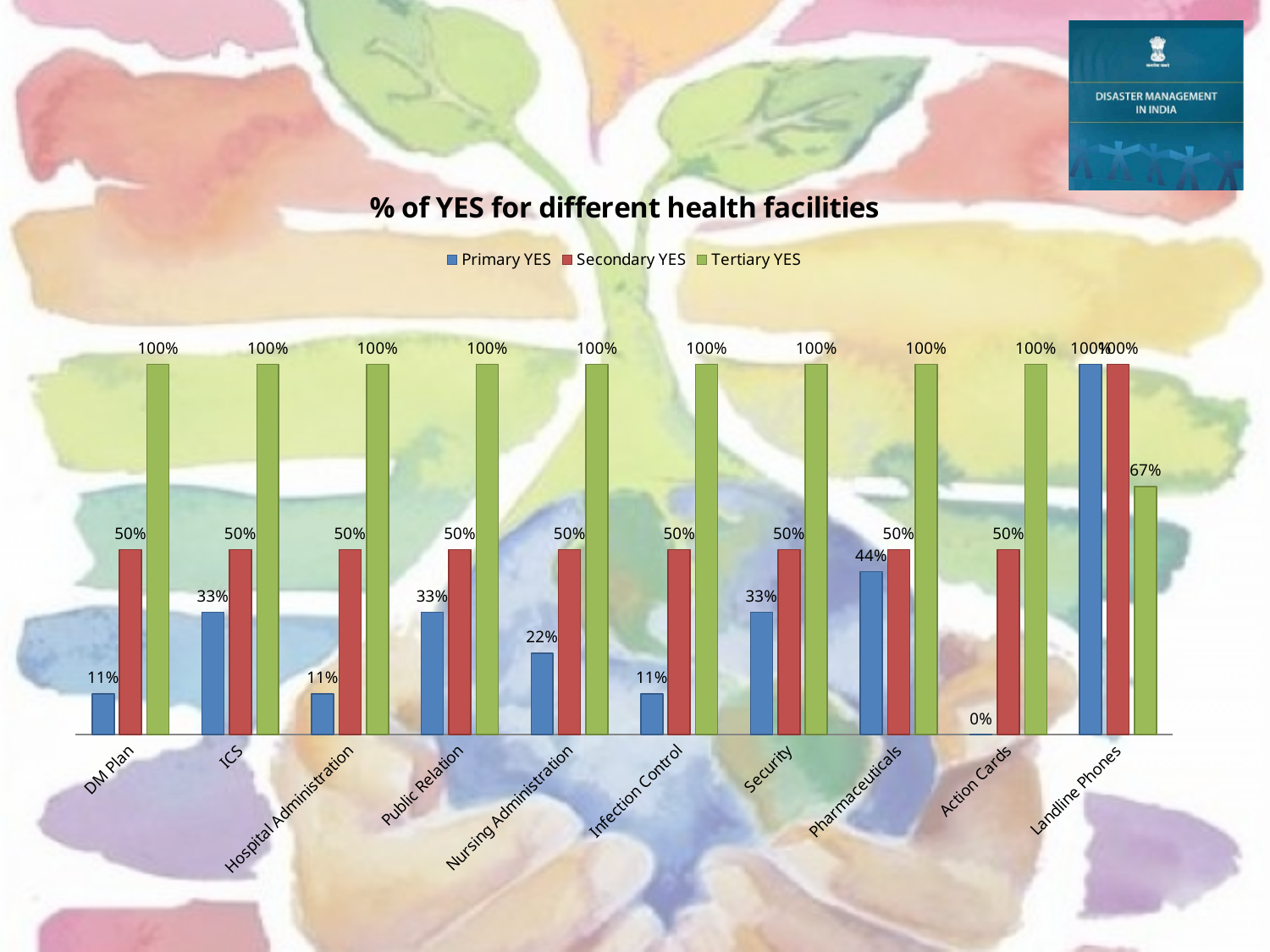
What is the difference between the Secondary YES and Primary YES values for DM Plan? 39% What is the Tertiary YES value for Landline Phones? 67% Which category has the lowest Tertiary YES value? Landline Phones Which category has the lowest Primary YES value? Action Cards How many series does the legend list? 3 How many categories are shown on the x axis? 10 What is the Secondary YES value for Infection Control? 50% Which is larger for Security: the Primary YES value or the Secondary YES value? Secondary YES Which category has the highest Primary YES value? Landline Phones What type of chart is shown on the slide? Bar chart What is the Primary YES value for Nursing Administration? 22% What is the Primary YES value for Pharmaceuticals? 44%